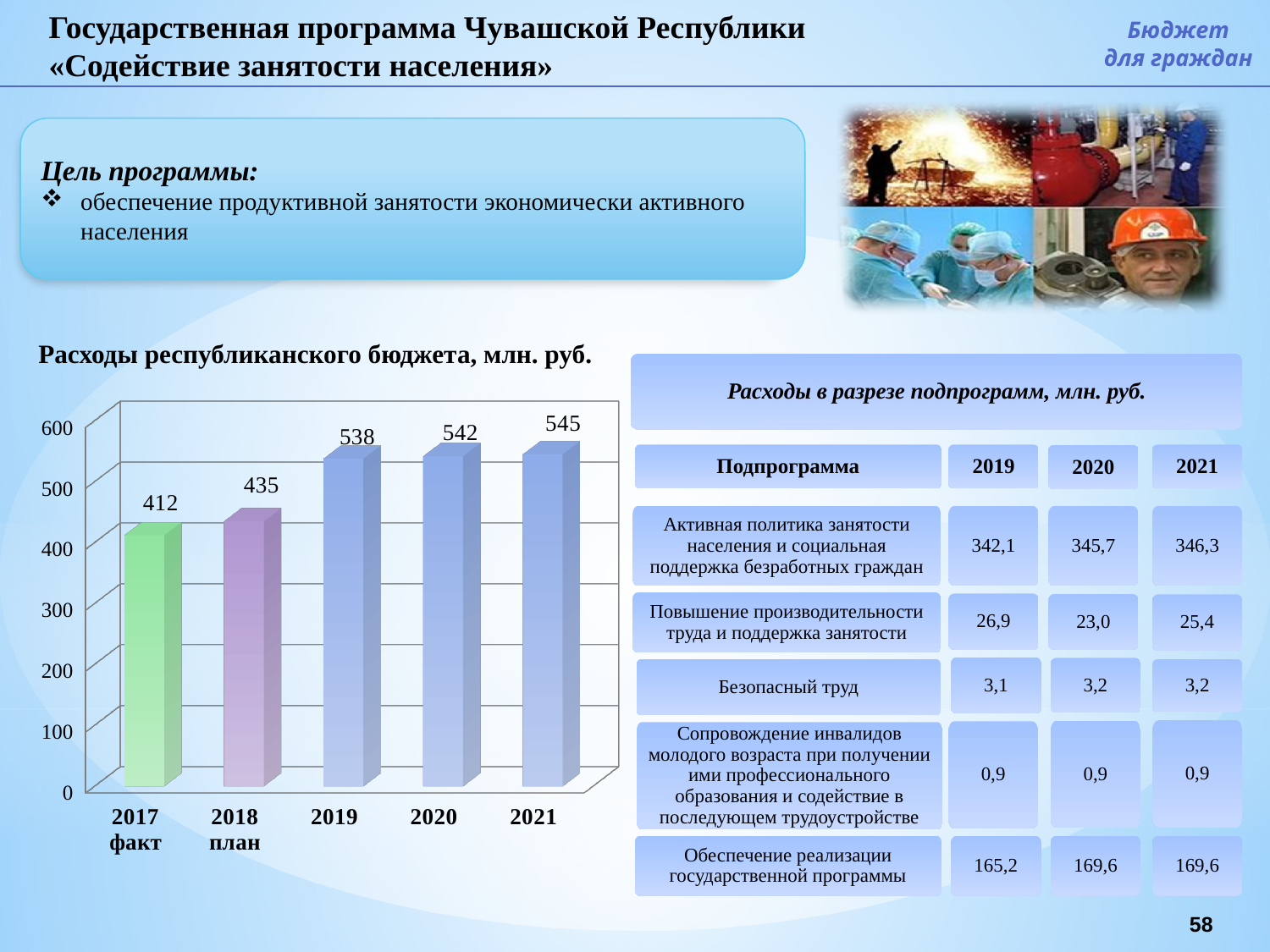
Which year has the lowest value in the chart? 2017 факт What is the difference between the values for 2019 and 2018 план in the chart? 103 Do the values in the chart rise or fall from 2017 to 2021? rise Which is larger in the chart, the value for 2018 план or the value for 2020? 2020 What kind of chart is shown on the slide? bar chart What is the value for 2021 in the chart? 545 How many bars are shown in the chart? 5 What is the value for 2017 факт in the chart? 412 What is the difference between the values for 2021 and 2017 факт in the chart? 133 Is the value for 2018 план greater or less than 500? less Which year has the highest value in the chart? 2021 What is the value for 2019 in the chart "Расходы республиканского бюджета, млн. руб."? 538